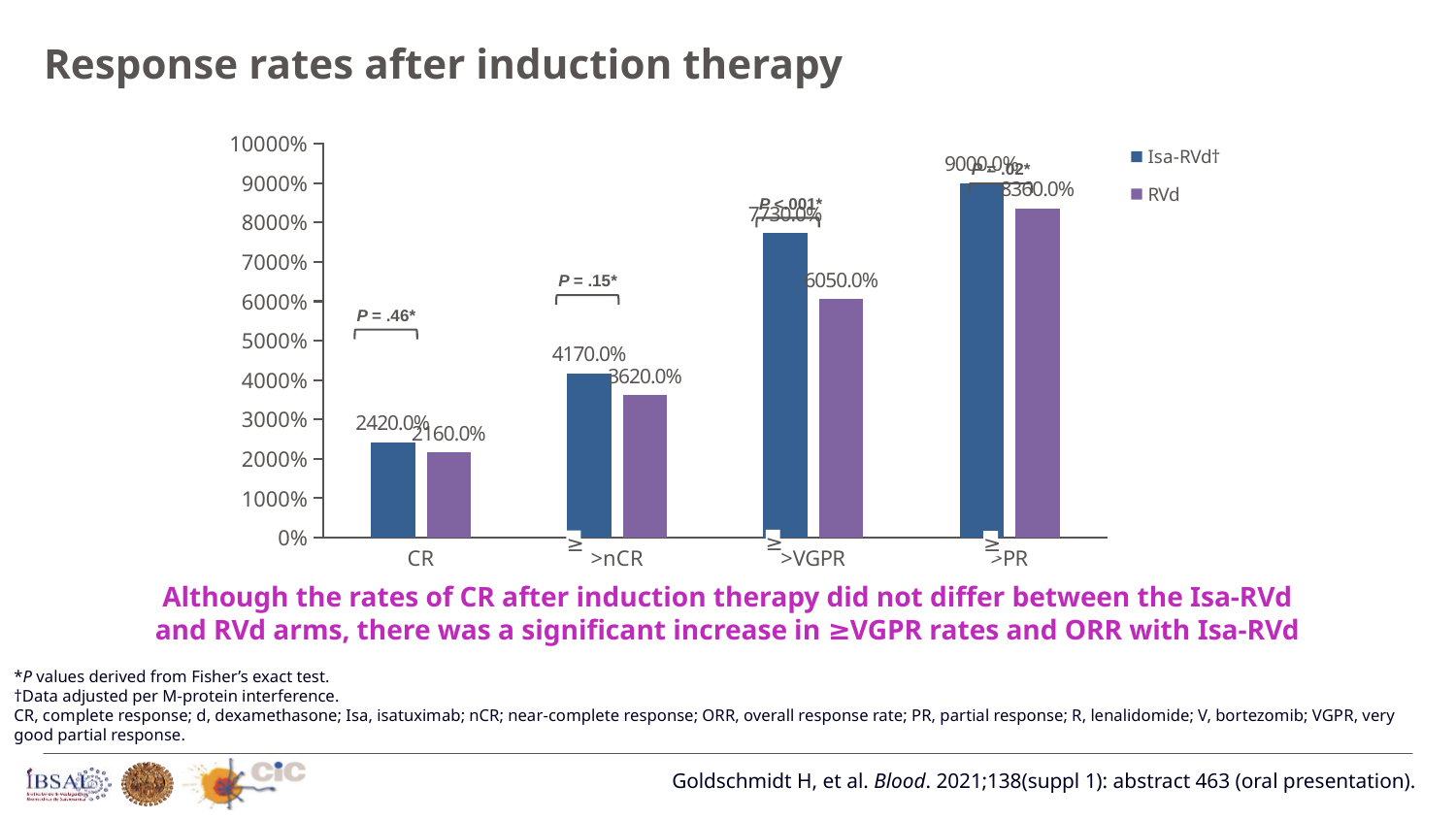
Which category has the lowest value for RVd? CR What is the value for Isa-RVd in the ≥nCR category? 4170.0% What is the value for RVd in the ≥VGPR category? 6050.0% Is the value for Isa-RVd in the ≥PR category greater or less than 8000%? greater Which series is shown in blue in the legend? Isa-RVd† What is the value for Isa-RVd in the CR category? 2420.0% How many series does the legend list? 2 What is the value for RVd in the ≥nCR category? 3620.0% How many response categories are shown on the x axis? 4 What is the difference between the Isa-RVd and RVd values in the ≥nCR category? 550.0% What is the value for RVd in the CR category? 2160.0% What kind of chart is shown on the slide? bar chart